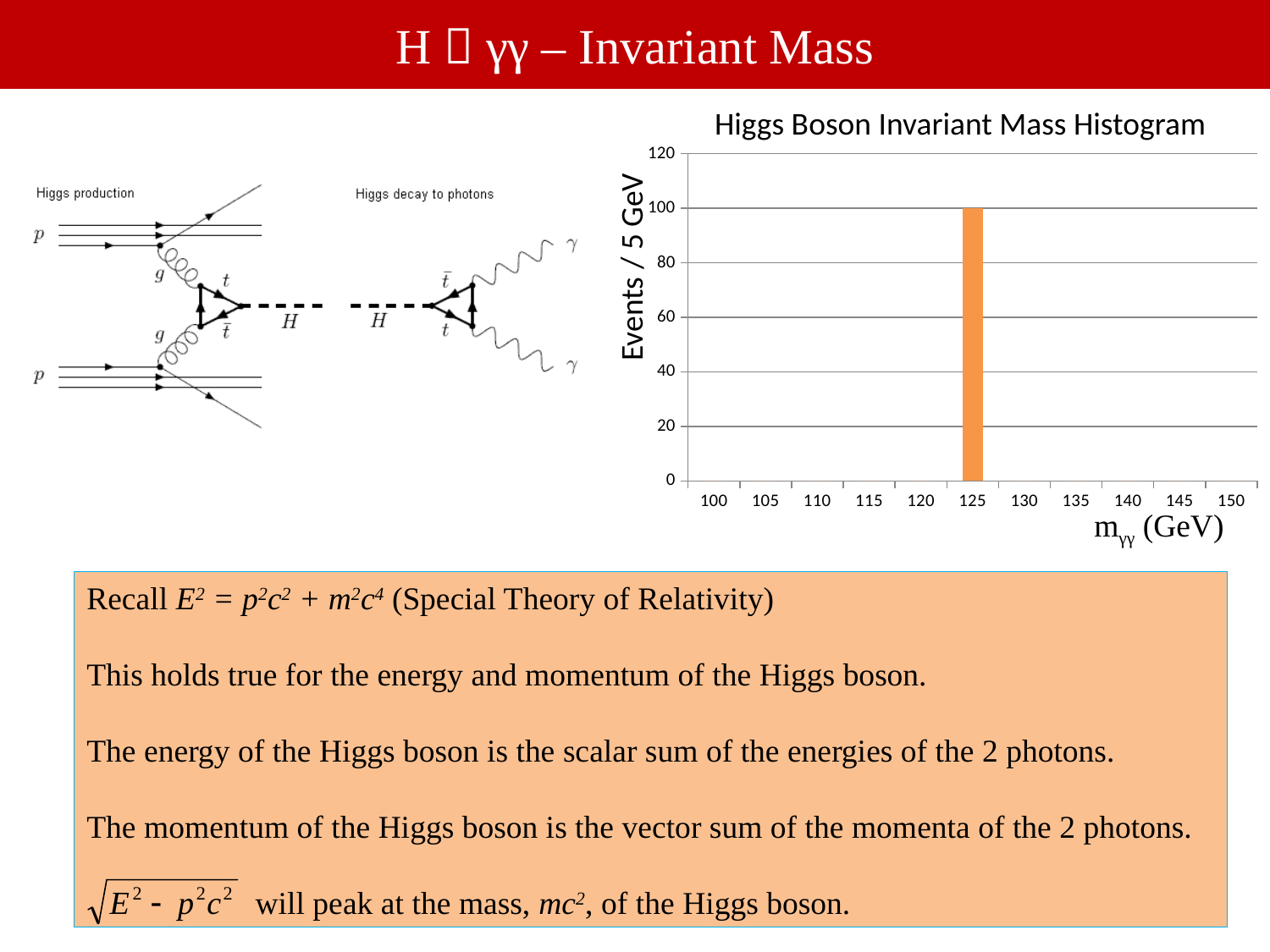
How many bars are plotted in the Higgs Boson Invariant Mass Histogram? 1 How many events per 5 GeV does the bar at 125 GeV reach in the Higgs Boson Invariant Mass Histogram? 100 At which mγγ value does the bar in the Higgs Boson Invariant Mass Histogram appear? 125 What kind of chart is the Higgs Boson Invariant Mass Histogram? bar chart What is the highest mγγ value labelled on the horizontal axis of the Higgs Boson Invariant Mass Histogram? 150 What is the label of the vertical axis in the Higgs Boson Invariant Mass Histogram? Events / 5 GeV What is the title of the chart on the slide? Higgs Boson Invariant Mass Histogram Is the value of the bar at 125 GeV in the Higgs Boson Invariant Mass Histogram greater or less than 120? less Is the value of the bar at 125 GeV in the Higgs Boson Invariant Mass Histogram greater or less than 80? greater What is the lowest mγγ value labelled on the horizontal axis of the Higgs Boson Invariant Mass Histogram? 100 What is the highest value shown on the vertical axis of the Higgs Boson Invariant Mass Histogram? 120 In the Higgs Boson Invariant Mass Histogram, is the value at 125 GeV larger or smaller than the value at 130 GeV? larger